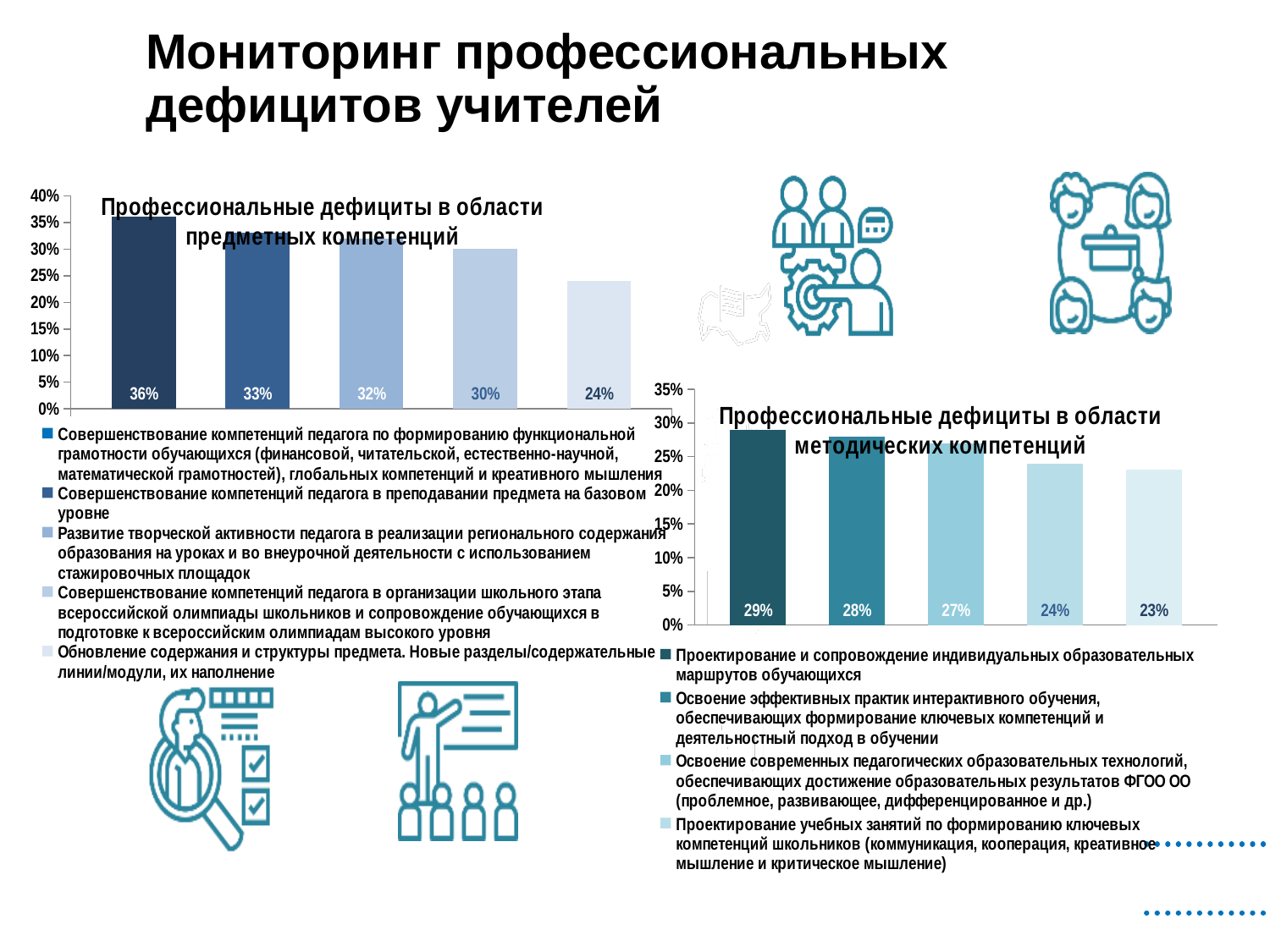
In the chart 'Профессиональные дефициты в области предметных компетенций', what is the difference between the highest and lowest values? 12% How many bars are plotted in the chart 'Профессиональные дефициты в области предметных компетенций'? 5 In the chart 'Профессиональные дефициты в области предметных компетенций', what is the value for 'Совершенствование компетенций педагога в преподавании предмета на базовом уровне'? 33% How many entries does the legend of the chart 'Профессиональные дефициты в области предметных компетенций' list? 5 In the chart 'Профессиональные дефициты в области методических компетенций', what is the value for 'Освоение современных педагогических образовательных технологий, обеспечивающих достижение образовательных результатов ФГОО ОО (проблемное, развивающее, дифференцированное и др.)'? 27% In the chart 'Профессиональные дефициты в области методических компетенций', do the bar values rise or fall from left to right? fall In the chart 'Профессиональные дефициты в области методических компетенций', what is the value for 'Проектирование и сопровождение индивидуальных образовательных маршрутов обучающихся'? 29% In the chart 'Профессиональные дефициты в области предметных компетенций', what is the value for 'Обновление содержания и структуры предмета. Новые разделы/содержательные линии/модули, их наполнение'? 24% In the chart 'Профессиональные дефициты в области методических компетенций', what is the lowest value shown on a bar? 23% What type of chart is 'Профессиональные дефициты в области предметных компетенций'? bar chart